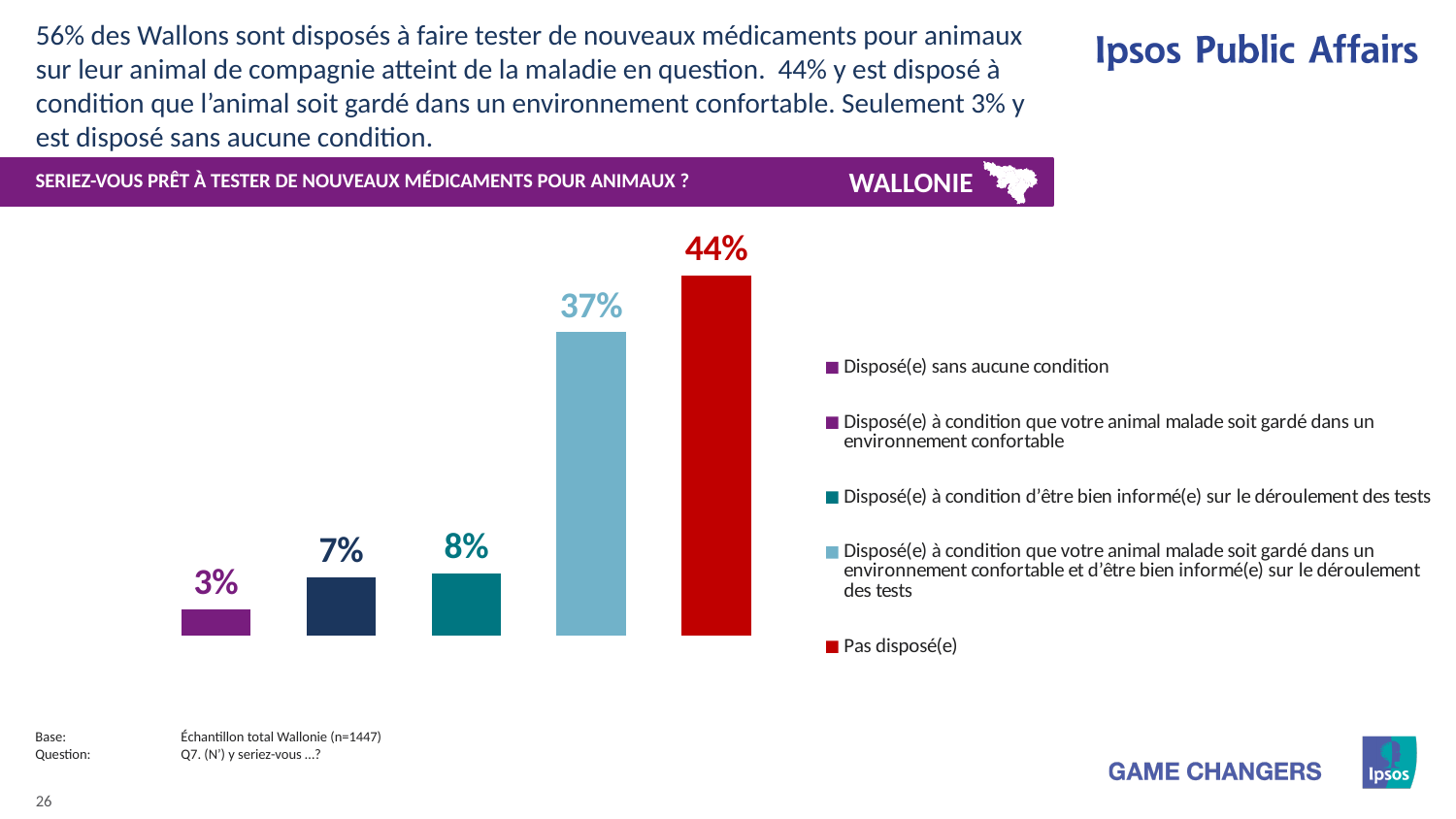
Which category has the highest value in the chart? Pas disposé(e) What colour is the bar for "Pas disposé(e)"? Red How many bars are shown in the chart? 5 What percentage of respondents are "Pas disposé(e)"? 44% What is the value for "Disposé(e) à condition que votre animal malade soit gardé dans un environnement confortable et d'être bien informé(e) sur le déroulement des tests"? 37% What is the difference between the "Pas disposé(e)" value and the 37% value? 7% What is the value for "Disposé(e) à condition d'être bien informé(e) sur le déroulement des tests"? 8% What type of chart is shown on the slide? Bar chart Which category has the lowest value in the chart? Disposé(e) sans aucune condition What percentage of respondents are "Disposé(e) sans aucune condition"? 3% Which is larger: the value for "Disposé(e) à condition que votre animal malade soit gardé dans un environnement confortable" or the value for "Disposé(e) à condition d'être bien informé(e) sur le déroulement des tests"? Disposé(e) à condition d'être bien informé(e) sur le déroulement des tests How many entries does the legend list? 5